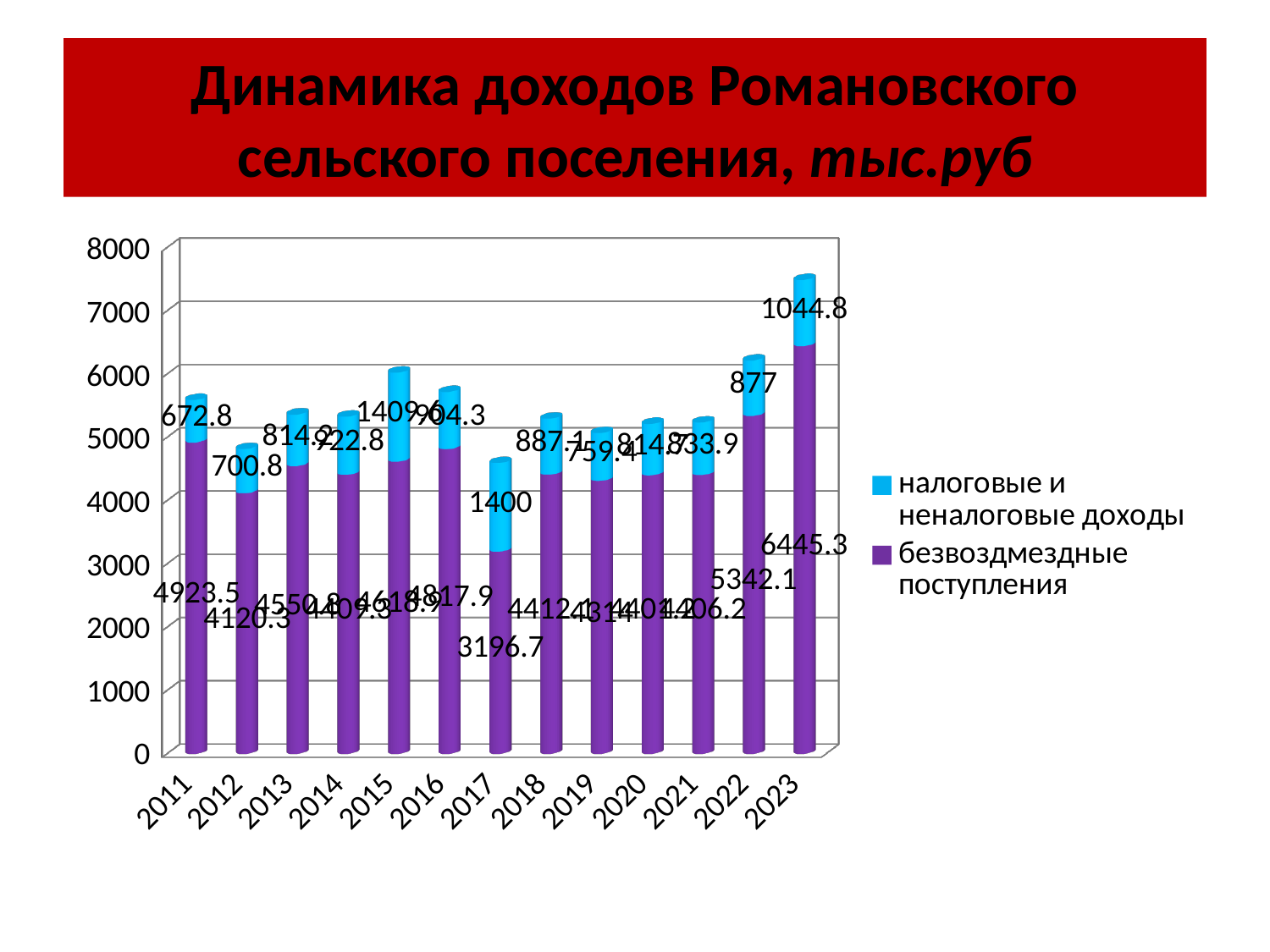
What is the value of безвоздмездные поступления for 2017? 3196.7 What is the value of безвоздмездные поступления for 2023? 6445.3 Which year has the lowest value of безвоздмездные поступления? 2017 What is the value of налоговые и неналоговые доходы for 2022? 877 What is the difference between безвоздмездные поступления in 2023 and in 2022? 1103.2 How many series does the legend list? 2 Which year has the highest total income bar? 2023 What is the total of the stacked bar for 2023? 7490.1 What is the value of налоговые и неналоговые доходы for 2011? 672.8 How many years are shown on the x axis of the chart? 13 Which year has the larger value of безвоздмездные поступления, 2012 or 2013? 2013 What kind of chart is shown on the slide? bar chart